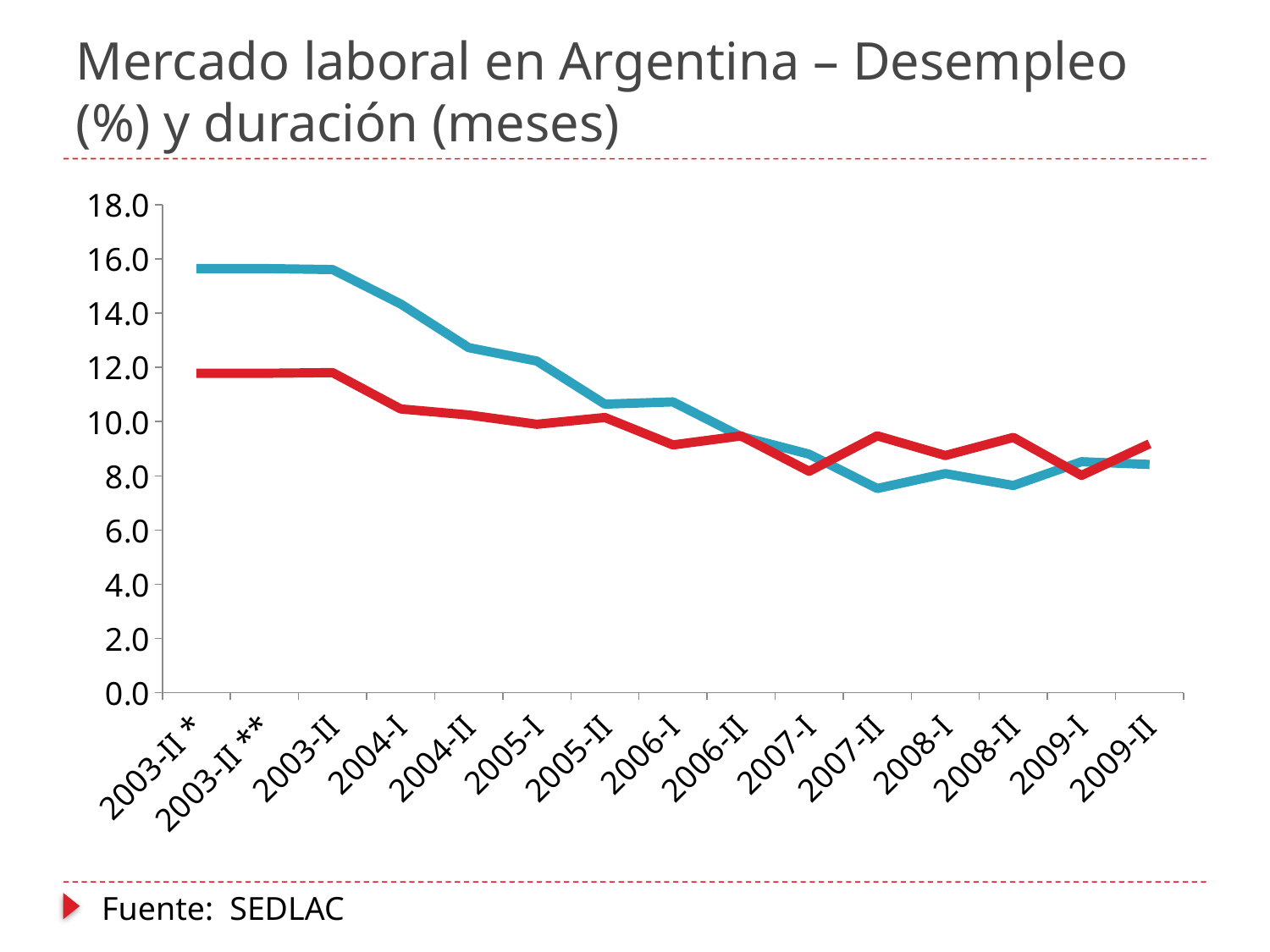
Is the value of the blue line at 2007-II greater or less than 8.0? less Is the value of the red line at 2007-I greater or less than 10.0? less Does the blue line overall rise or fall from 2003-II * to 2009-II? fall What kind of chart is shown on the slide? line chart Is the value of the blue line at 2003-II greater or less than 14.0? greater At 2007-II, which line has the higher value, the blue line or the red line? the red line At 2003-II, which line has the higher value, the blue line or the red line? the blue line How many points are plotted along the x axis of the chart? 15 What is the title of the chart on the slide? Mercado laboral en Argentina – Desempleo (%) y duración (meses) What source is cited for the chart? SEDLAC